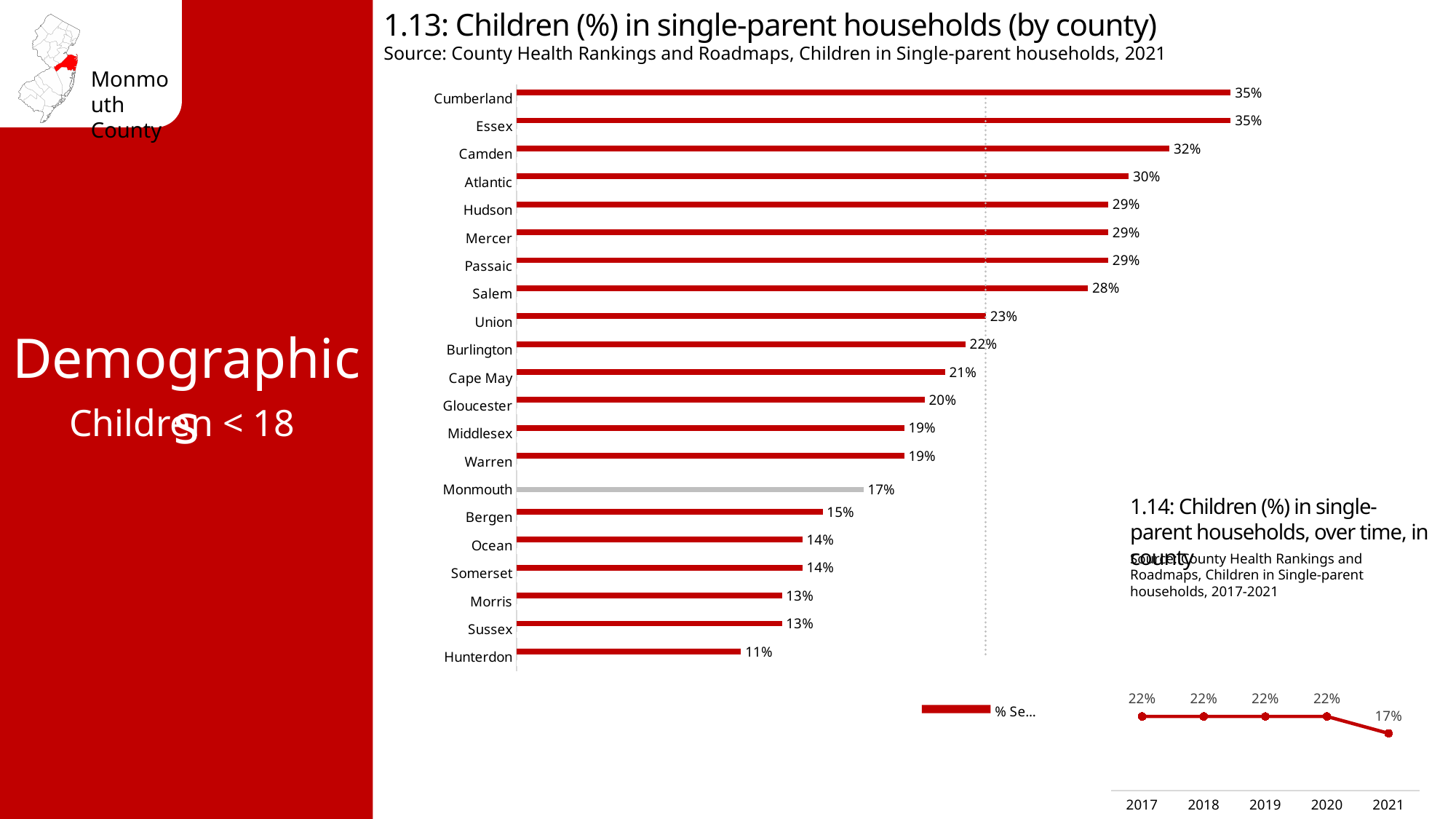
In chart 1.14 (over time, in county), how many years are plotted? 5 In chart 1.13 (by county), which is larger, the value for Union or the value for Bergen? Union In chart 1.13 (by county), what is the difference between the values for Cumberland and Monmouth? 18 percentage points In chart 1.13 (by county), how many counties are shown? 21 In chart 1.13 (by county), which county has the lowest percentage of children in single-parent households? Hunterdon What kind of chart is chart 1.13 (Children in single-parent households by county)? Bar chart In chart 1.13 (by county), what is the value for Camden? 32% In chart 1.14 (over time, in county), what is the value for 2021? 17% In chart 1.13 (Children in single-parent households by county), what is the value for Monmouth? 17% In chart 1.13 (by county), which bar is coloured grey instead of red? Monmouth In chart 1.14 (over time, in county), what is the difference between the 2020 and 2021 values? 5 percentage points In chart 1.14 (over time, in county), do the values rise or fall from 2020 to 2021? Fall